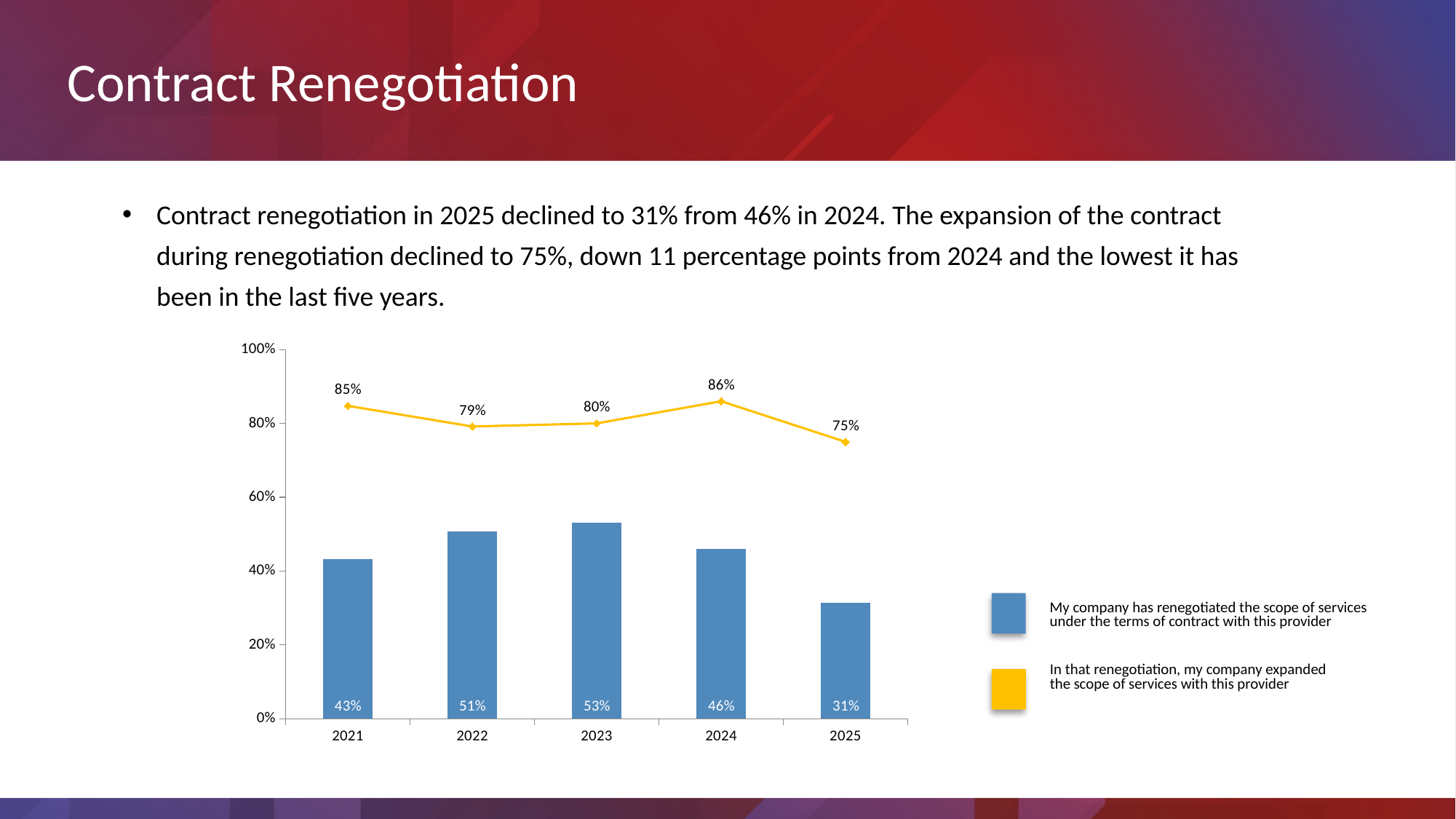
How many years are shown on the x axis? 5 What is the value of the bar for 2025? 31% What is the difference between the line values for 2024 and 2025? 11% Which is larger, the bar value for 2021 or the bar value for 2022? 2022 What is the value of the bar for 2023? 53% What is the difference between the bar values for 2024 and 2025? 15% How many series does the legend list? 2 Which year has the lowest value on the line series for expanded scope of services? 2025 What colour is the line series for expanded scope of services? Yellow What is the value of the line series (expanded the scope of services) for 2024? 86% Does the bar series rise or fall from 2023 to 2025? fall Which year has the highest bar value for renegotiated scope of services? 2023